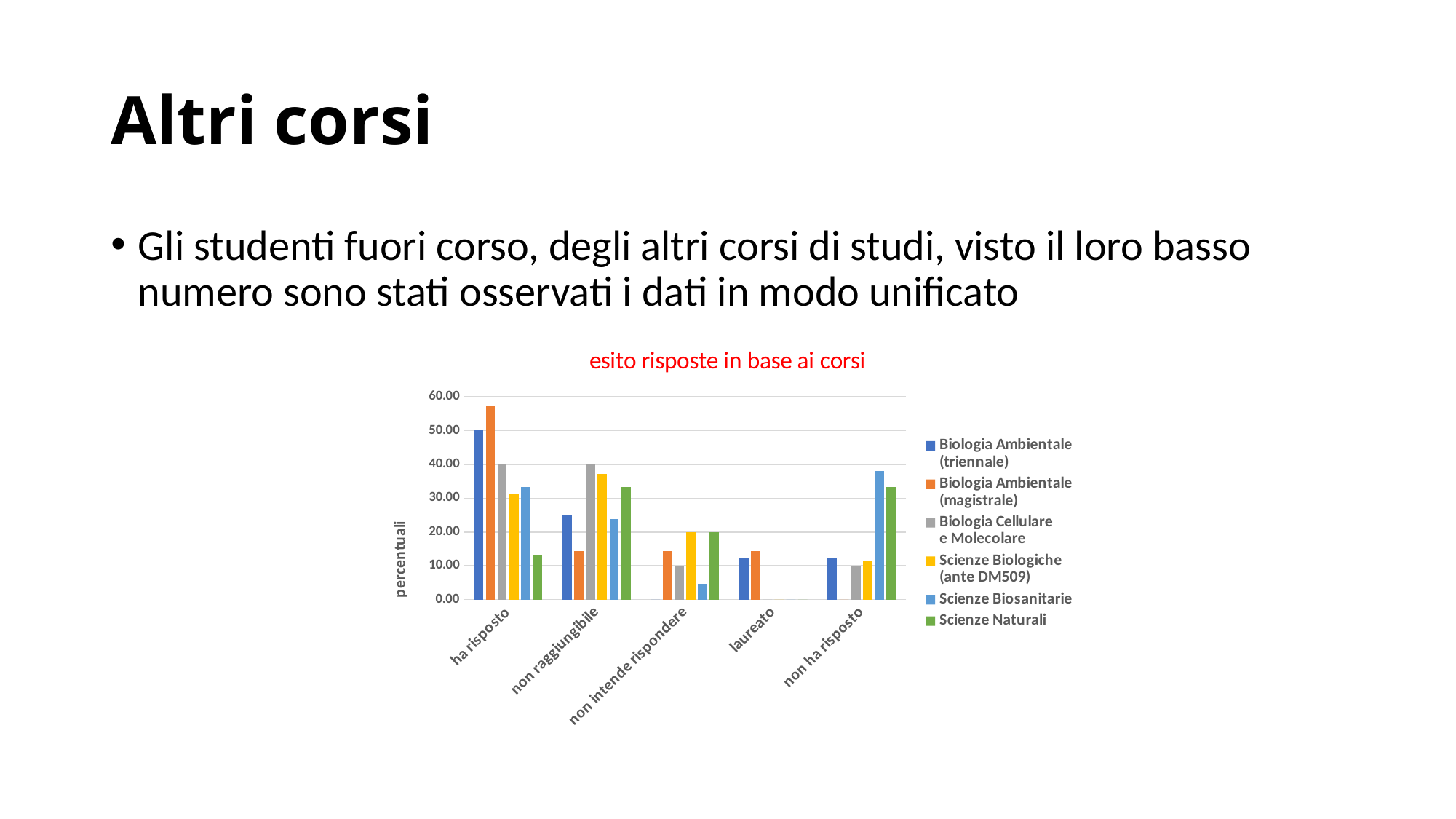
Which series has the highest value in the 'ha risposto' category? Biologia Ambientale (magistrale) In the 'ha risposto' category, which is larger: the value for Scienze Biosanitarie or the value for Scienze Naturali? Scienze Biosanitarie What is the value for Biologia Cellulare e Molecolare in the 'non raggiungibile' category? 40.00 What is the label of the vertical axis of the chart? percentuali Is the value for Biologia Ambientale (magistrale) in the 'ha risposto' category greater or less than 50? greater What is the title of the chart? esito risposte in base ai corsi What kind of chart is shown on the slide? bar chart Which series has the highest value in the 'non ha risposto' category? Scienze Biosanitarie How many series does the chart legend list? 6 How many categories are shown on the x axis of the chart? 5 What is the value for Biologia Ambientale (triennale) in the 'ha risposto' category? 50.00 Is the value for Scienze Naturali in the 'ha risposto' category greater or less than 20? less